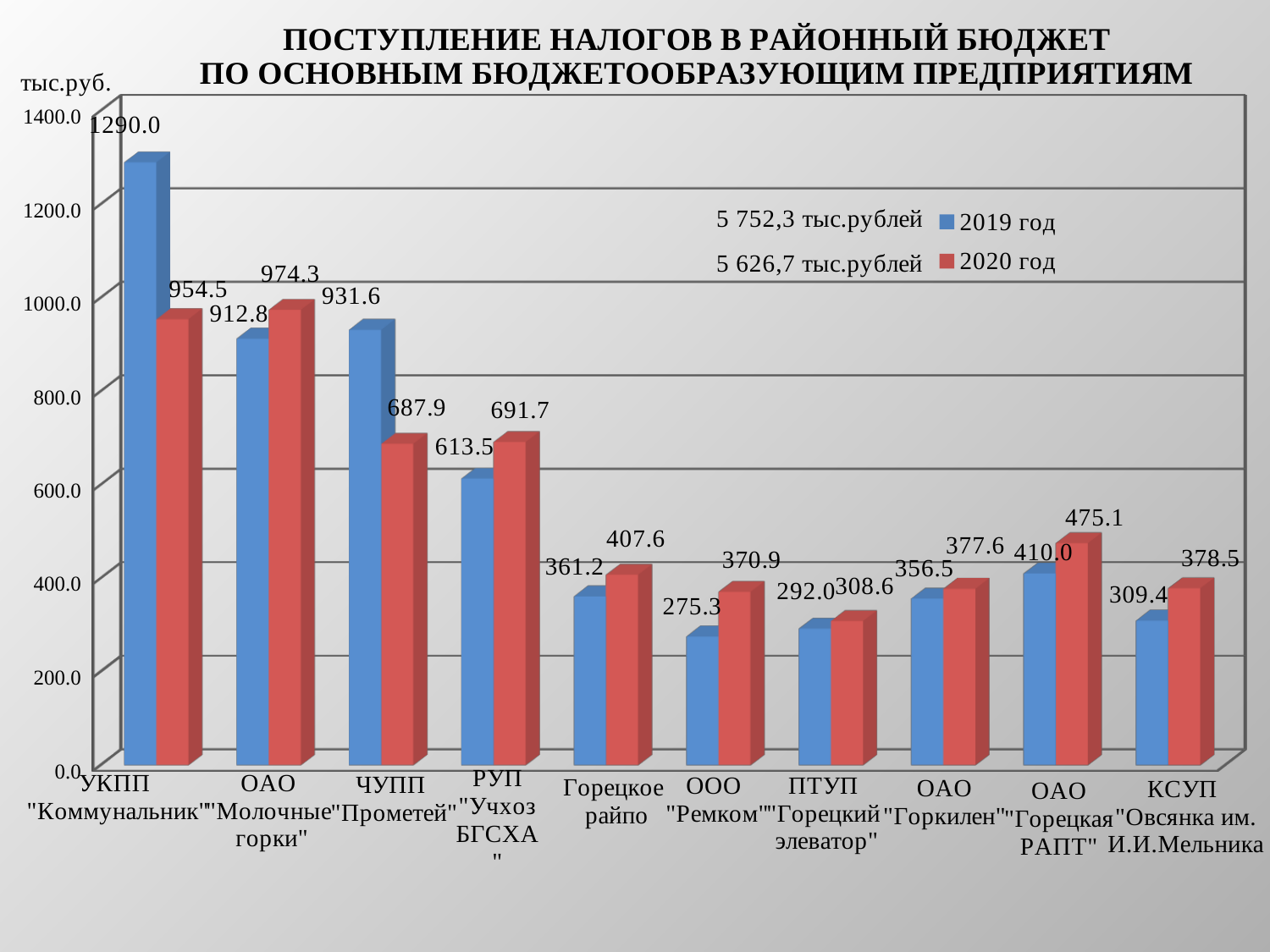
Which enterprise had the highest 2019 год value? УКПП "Коммунальник" How many series does the legend list? 2 What was the 2019 год value for УКПП "Коммунальник"? 1290.0 What was the 2020 год value for ОАО "Горецкая РАПТ"? 475.1 Which is larger for РУП "Учхоз БГСХА": the 2019 год value or the 2020 год value? 2020 год Which enterprise had the lowest 2019 год value? ООО "Ремком" What is the difference between the 2019 год and 2020 год values for УКПП "Коммунальник"? 335.5 What was the 2020 год value for ООО "Ремком"? 370.9 Which is larger for ЧУПП "Прометей": the 2019 год value or the 2020 год value? 2019 год How many enterprises are shown on the x axis? 10 What type of chart is shown on the slide? Bar chart Which enterprise had the highest 2020 год value? ОАО "Молочные горки"